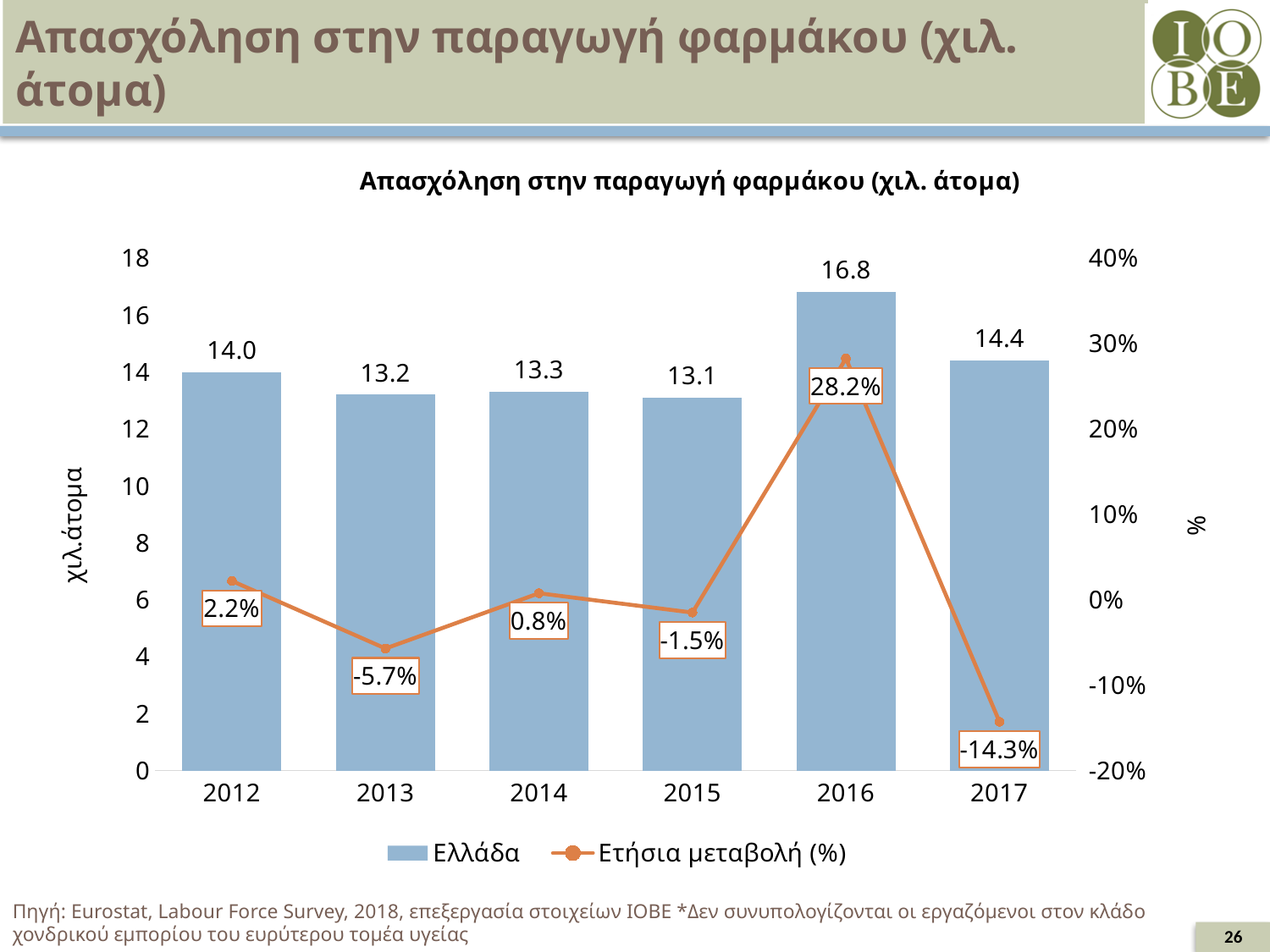
What is the value for Ελλάδα in 2016? 16.8 Is the Ελλάδα value for 2016 greater or less than 16? greater Does the Ετήσια μεταβολή (%) value rise or fall from 2016 to 2017? fall What is the label of the left vertical axis? χιλ.άτομα Which year has the highest value for Ελλάδα? 2016 What kind of chart is used for the Ελλάδα series? bar chart Which year has the lowest Ετήσια μεταβολή (%) value? 2017 What is the Ετήσια μεταβολή (%) value for 2013? -5.7% What is the difference between the Ελλάδα values for 2016 and 2017? 2.4 How many series does the legend list? 2 Which is larger, the Ελλάδα value for 2012 or for 2015? 2012 How many years are shown on the x axis? 6